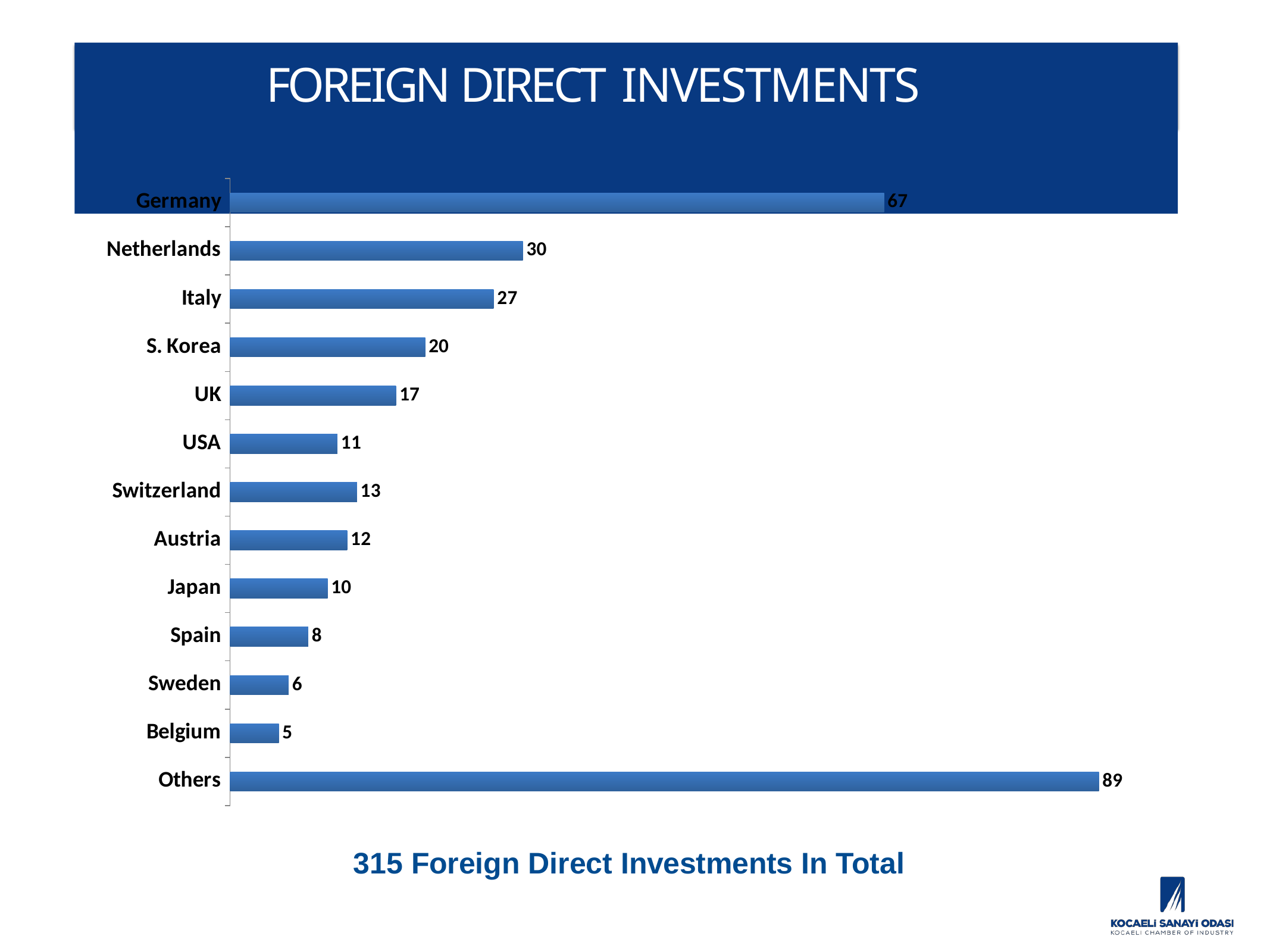
What is the difference between the values for Italy and S. Korea? 7 What kind of chart is shown on the slide? Bar chart What is the value for Belgium? 5 What is the value for Germany? 67 What is the value for Switzerland? 13 Which is larger, the value for USA or the value for Switzerland? Switzerland What is the difference between the values for Germany and Netherlands? 37 How many categories are shown in the chart? 13 Which category has the highest value? Others Which category has the lowest value? Belgium What is the title of the slide? FOREIGN DIRECT INVESTMENTS What is the value for Netherlands? 30